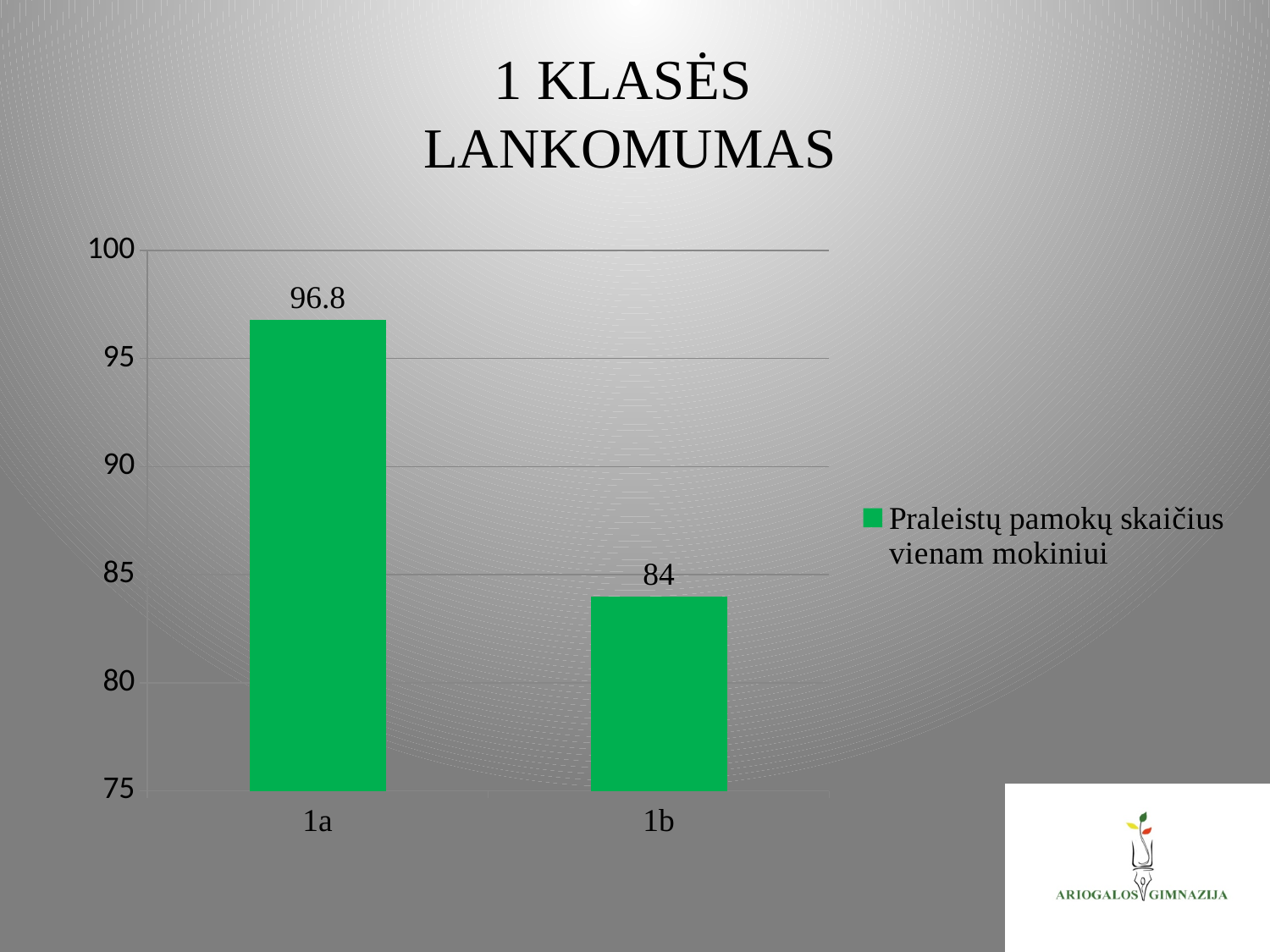
Is the value for 1a greater or less than 95? greater How many series does the legend list? 1 Is the value for 1b greater or less than 85? less Which class has the highest value? 1a What is the value for 1b? 84 What is the title of the slide? 1 KLASĖS LANKOMUMAS What kind of chart is shown on the slide? bar chart What is the difference between the values for 1a and 1b? 12.8 What is the value for 1a? 96.8 Which is larger, the value for 1a or the value for 1b? 1a Which class has the lowest value? 1b How many categories are shown on the x axis? 2